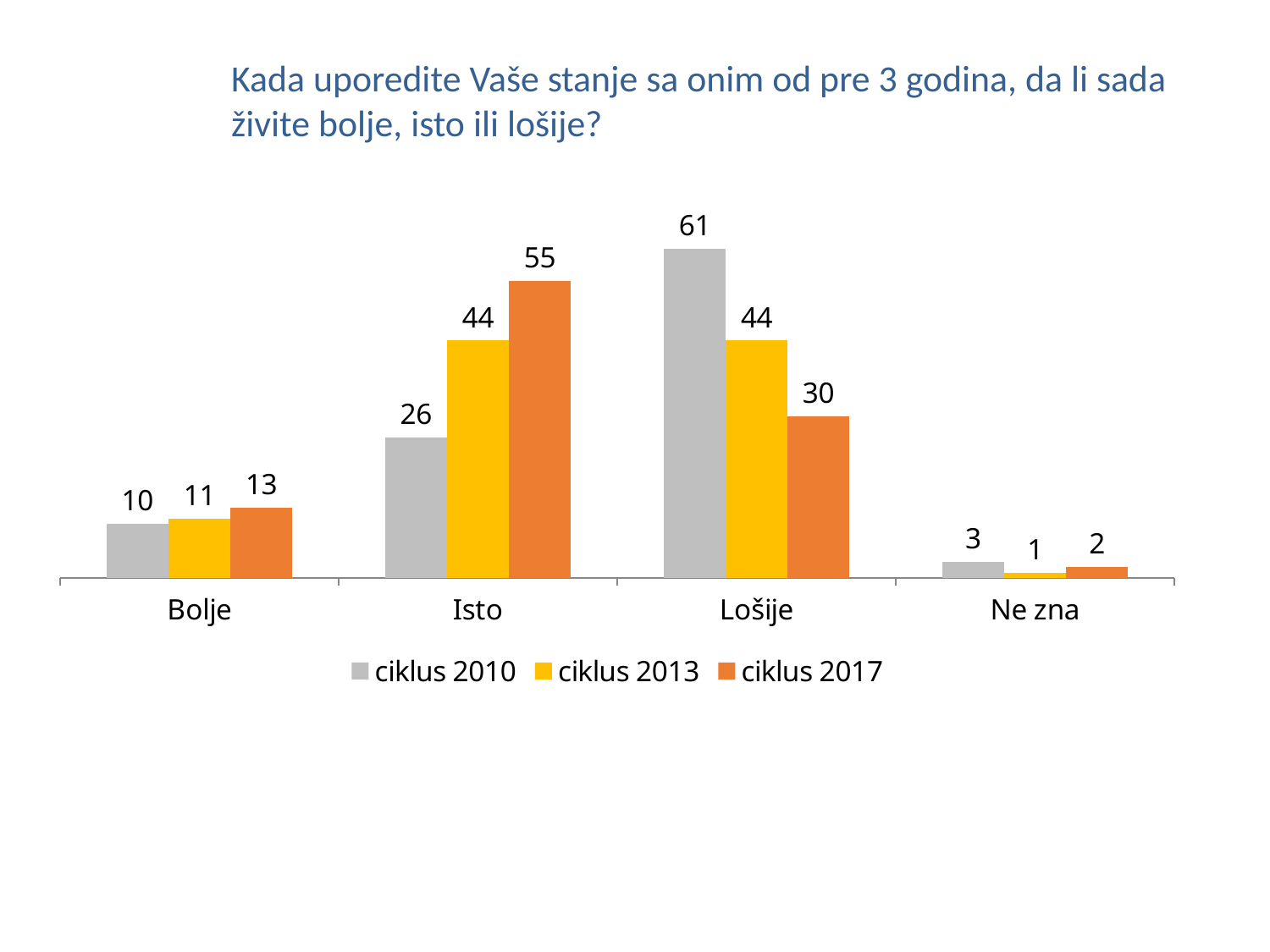
What is the value for 'Bolje' in the ciklus 2013 series? 11 What is the value for 'Ne zna' in the ciklus 2017 series? 2 How many series does the legend list? 3 What is the value for 'Lošije' in the ciklus 2010 series? 61 What is the difference between the ciklus 2010 and ciklus 2017 values for 'Lošije'? 31 Which category has the lowest value in the ciklus 2013 series? Ne zna What kind of chart is shown on the slide? Bar chart What is the value for 'Isto' in the ciklus 2017 series? 55 How many categories are shown on the x axis? 4 Which series is shown in orange in the legend? ciklus 2017 Which category has the highest value in the ciklus 2017 series? Isto Which is larger for 'Isto': the ciklus 2010 value or the ciklus 2013 value? ciklus 2013